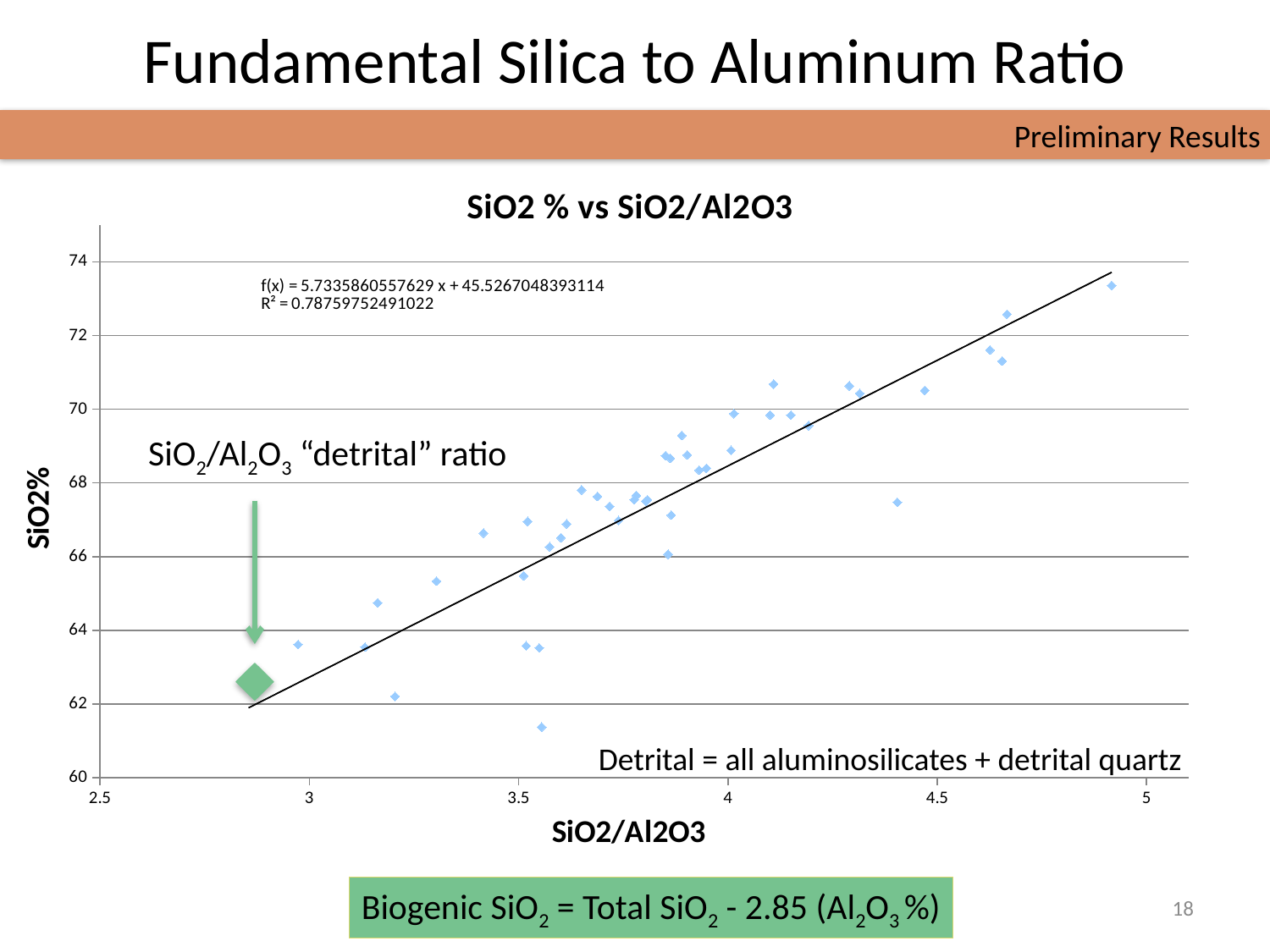
What is the intercept of the fitted line f(x) printed on the chart? 45.5267048393114 Is the SiO2% value of the point with the largest SiO2/Al2O3 ratio greater or less than 72? greater What is the title of the chart? SiO2 % vs SiO2/Al2O3 What is the label of the y axis of the chart? SiO2% What is the slope of the fitted line f(x) printed on the chart? 5.7335860557629 Is the lowest SiO2% value plotted on the chart greater or less than 62? less What R² value is printed on the chart for the fitted line? 0.78759752491022 What kind of chart is shown on the slide? scatter chart Is the highest SiO2% value plotted on the chart greater or less than 72? greater What SiO2/Al2O3 "detrital" ratio value is used in the Biogenic SiO2 formula shown below the chart? 2.85 Do the SiO2% values generally rise or fall as the SiO2/Al2O3 ratio increases along the x axis? rise